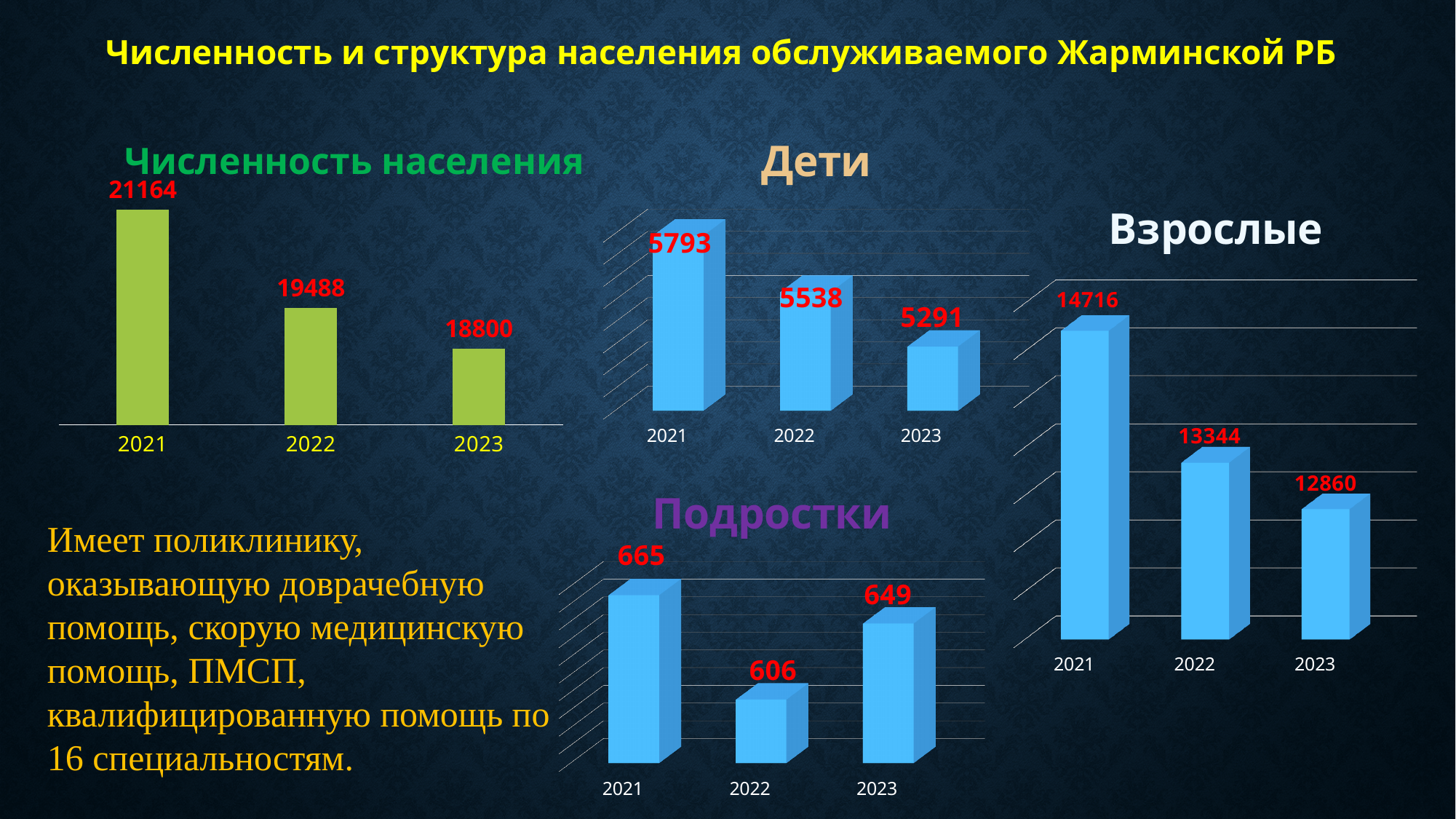
In the 'Численность населения' chart, what is the value for 2023? 18800 What type of chart is the 'Дети' chart? bar chart In the 'Подростки' chart, which year has the lowest value? 2022 In the 'Подростки' chart, which is larger, the value for 2021 or the value for 2023? 2021 In the 'Численность населения' chart, what is the difference between the 2021 and 2022 values? 1676 In the 'Численность населения' chart, do the values rise or fall from 2021 to 2023? fall How many bars are in the 'Взрослые' chart? 3 In the 'Численность населения' chart, what is the value for 2021? 21164 In the 'Взрослые' chart, which year has the highest value? 2021 In the 'Взрослые' chart, what is the value for 2021? 14716 In the 'Дети' chart, what is the value for 2022? 5538 In the 'Дети' chart, what is the difference between the 2021 and 2023 values? 502